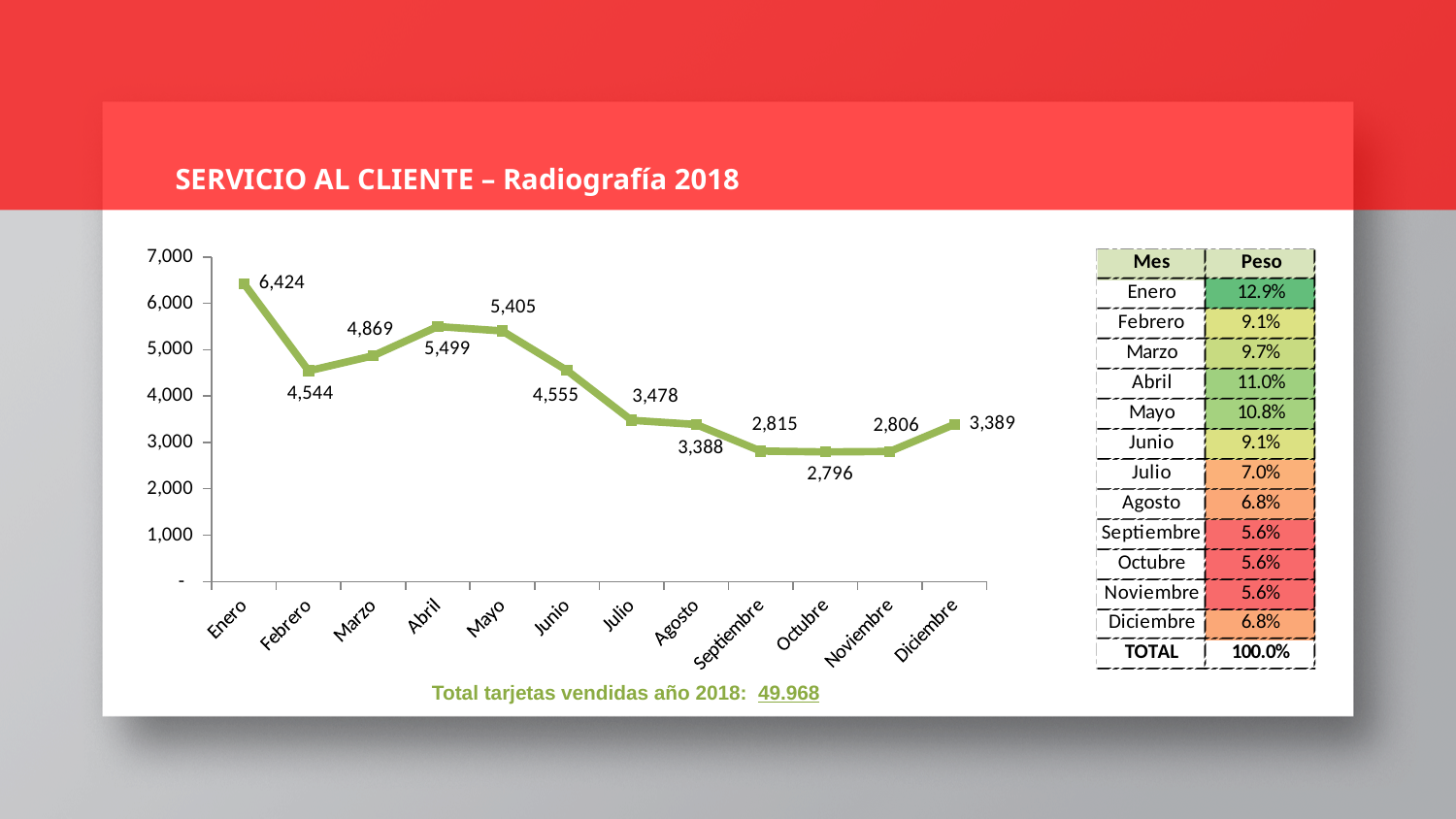
What kind of chart is shown on the slide? line chart What is the difference between the values for Enero and Febrero? 1,880 What is the value for Octubre? 2,796 Which month has the highest value? Enero What is the value for Enero? 6,424 Is the value for Julio greater or less than 3,000? greater Which month has the lowest value? Octubre Do the values generally rise or fall from Enero to Noviembre? fall Which is larger, the value for Marzo or the value for Junio? Marzo What is the value for Diciembre? 3,389 How many months are plotted on the chart? 12 What is the difference between the values for Abril and Mayo? 94